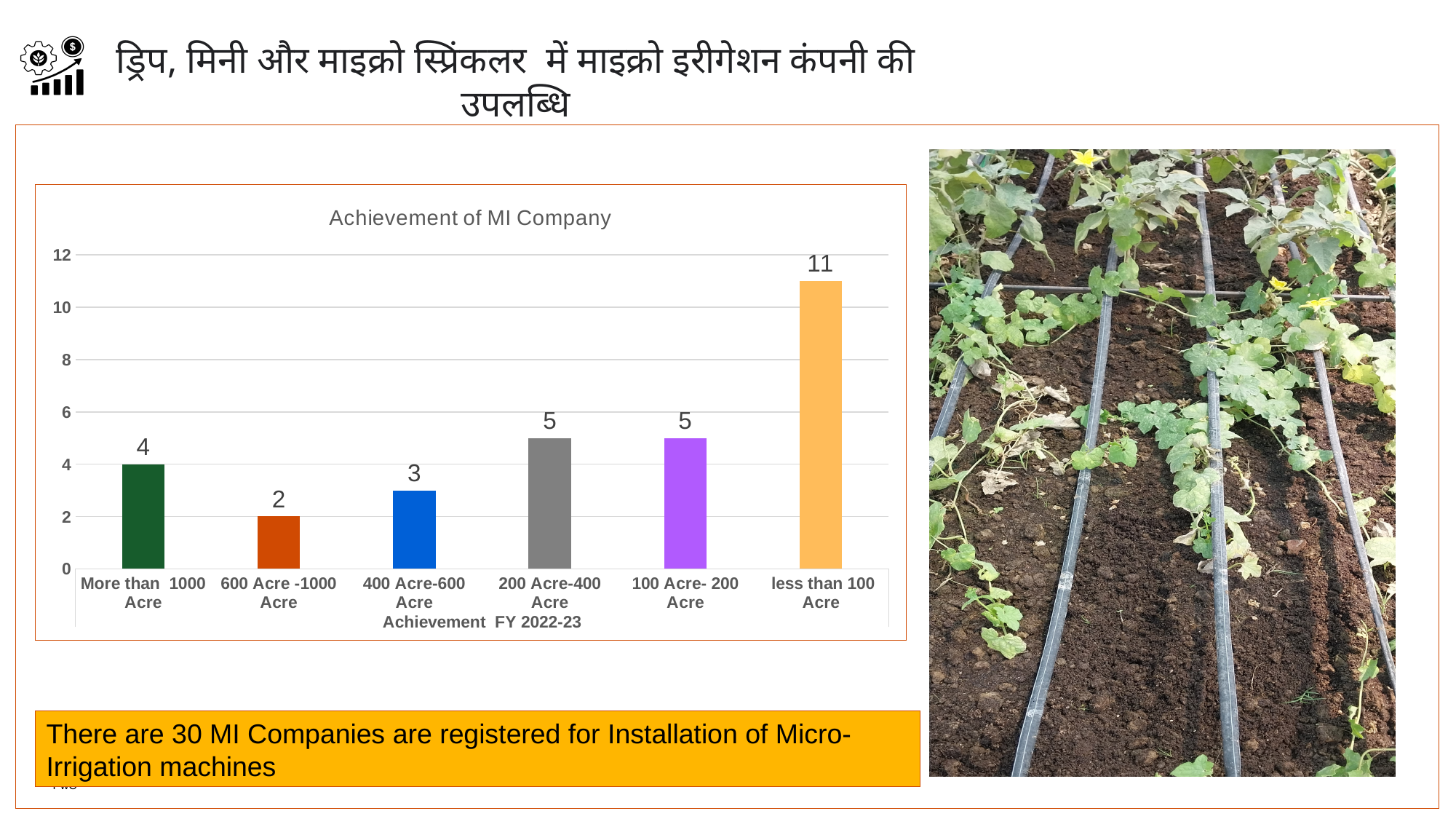
What is the value for the 'More than 1000 Acre' category? 4 What is the value for the '400 Acre-600 Acre' category? 3 What is the title of the chart? Achievement of MI Company What is the difference between the values for 'less than 100 Acre' and '200 Acre-400 Acre'? 6 Which category has the highest value? less than 100 Acre Which is larger, the value for 'More than 1000 Acre' or the value for '400 Acre-600 Acre'? More than 1000 Acre What is the value for the 'less than 100 Acre' category? 11 What is the value for the '600 Acre -1000 Acre' category? 2 Which category has the lowest value? 600 Acre -1000 Acre How many categories are shown on the x axis? 6 What kind of chart is shown on the slide? bar chart What is the x-axis label of the chart? Achievement FY 2022-23